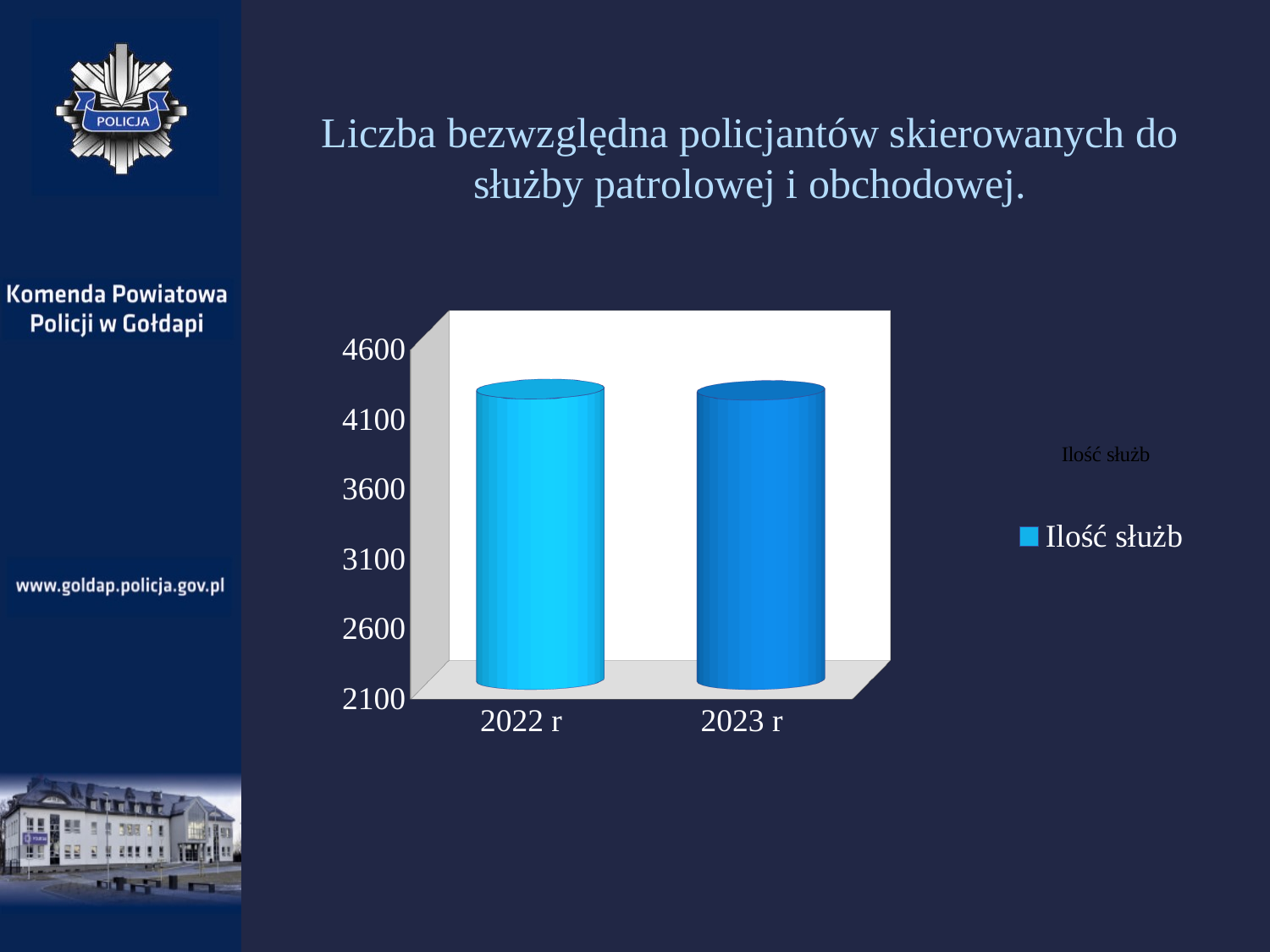
What kind of chart is shown on the slide? bar chart Is the value for 2022 r greater or less than 4100? greater Is the value for 2023 r greater or less than 4100? greater What is the lowest value shown on the chart's vertical axis? 2100 What is the highest value shown on the chart's vertical axis? 4600 Is the value for 2022 r greater or less than 4600? less What is the name of the series shown in the chart legend? Ilość służb What is the title of the chart on the slide? Liczba bezwzględna policjantów skierowanych do służby patrolowej i obchodowej. How many series does the chart legend list? 1 How many categories are plotted on the x axis of the chart? 2